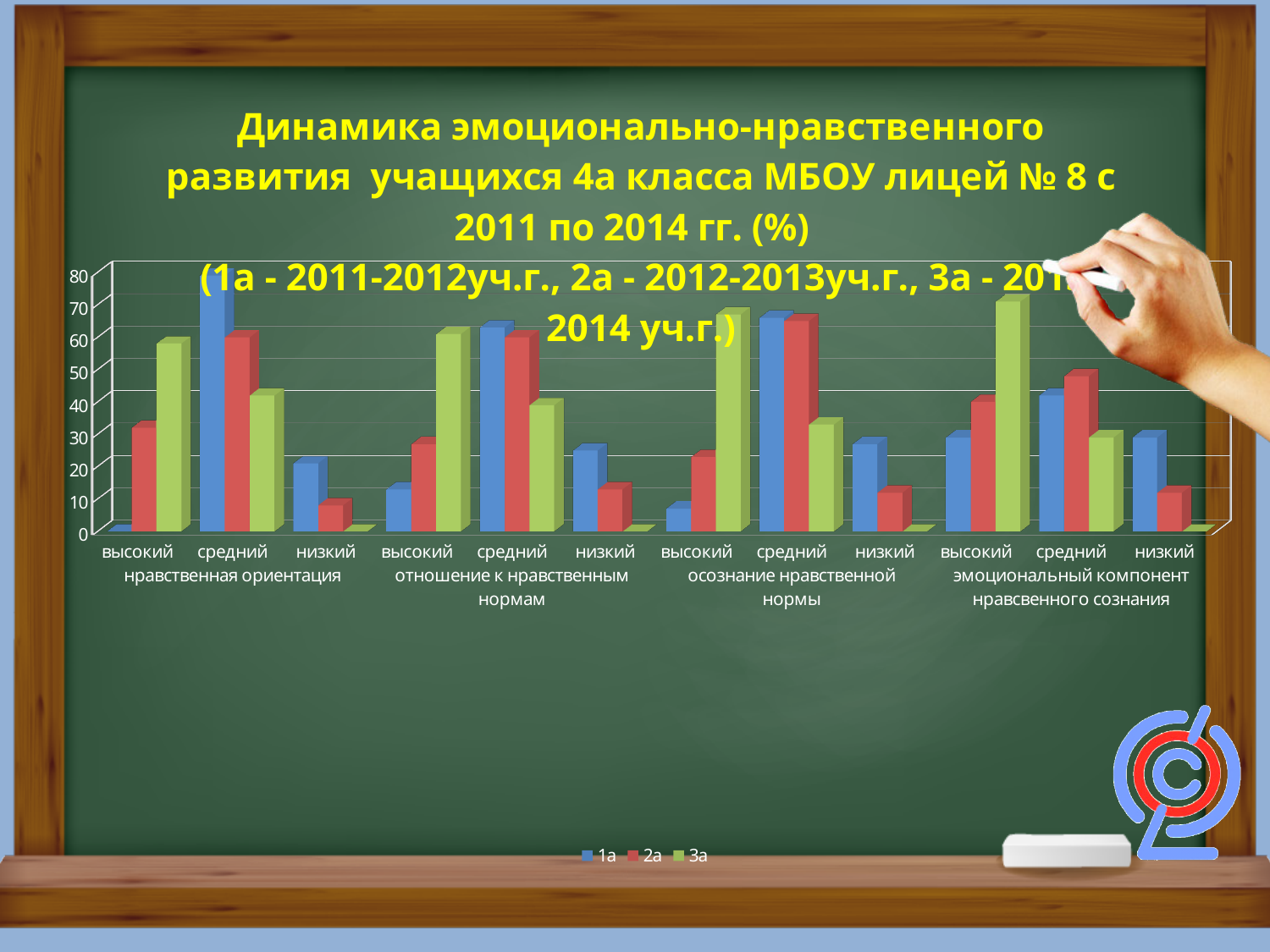
How many categories are shown along the x axis? 12 How many series does the legend list? 3 Is the value for 2а at 'низкий' under 'нравственная ориентация' greater or less than 20? less Is the value for 3а at 'высокий' under 'нравственная ориентация' greater or less than 50? greater Is the value for 1а at 'средний' under 'нравственная ориентация' greater or less than 70? greater Which series has the highest value at 'средний' under 'нравственная ориентация'? 1а Which series has the lowest value at 'низкий' under 'осознание нравственной нормы'? 3а At 'высокий' under 'отношение к нравственным нормам', which is larger: the value for 1а or for 3а? 3а What kind of chart is shown on the slide? bar chart What are the series names listed in the legend? 1а, 2а, 3а For series 3а under 'нравственная ориентация', do the values rise or fall going from 'высокий' to 'низкий'? fall